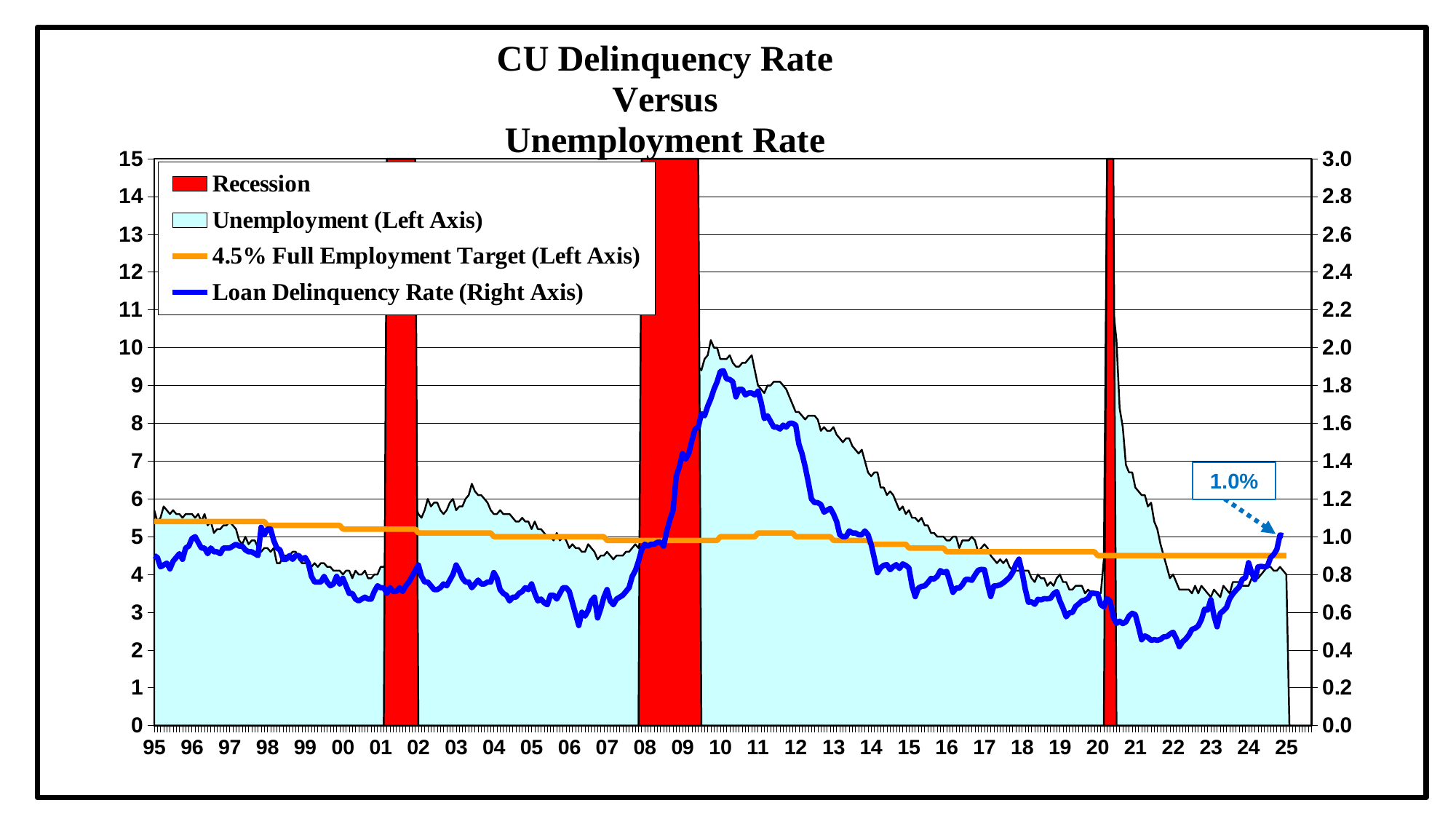
How many entries does the chart legend list? 4 Is the Unemployment value in 2019 greater or less than 5? less Does the Loan Delinquency Rate rise or fall between 2021 and 2025? rise How many recession periods are shaded on the chart? 3 Is the Unemployment value in 2010 greater or less than 8? greater In which year does the Unemployment series reach its highest peak? 2020 Is the Loan Delinquency Rate in 2021 greater or less than 0.6? less Does the Unemployment series rise or fall between 2010 and 2019? fall What kind of chart is used to plot the Loan Delinquency Rate series? Line chart What value is labelled for the Loan Delinquency Rate at the end of the series in 2025? 1.0% Is the Loan Delinquency Rate higher in 2010 or in 2022? 2010 What is the title of the chart? CU Delinquency Rate Versus Unemployment Rate